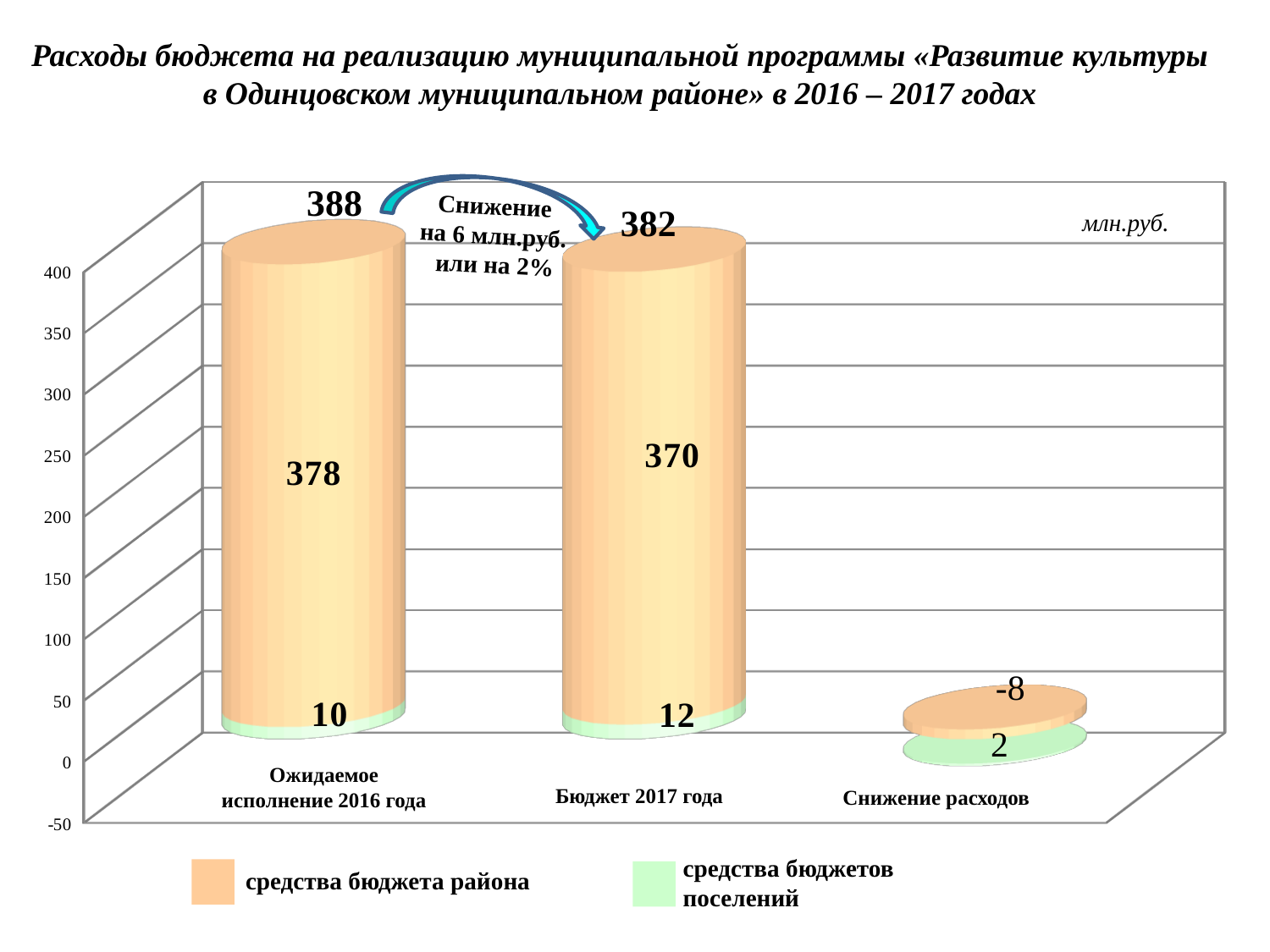
Which is larger: «средства бюджетов поселений» for «Ожидаемое исполнение 2016 года» or for «Бюджет 2017 года»? Бюджет 2017 года How many categories are shown on the x axis? 3 How many series does the legend list? 2 What is the total of the stacked bar for «Ожидаемое исполнение 2016 года»? 388 What is the total of the stacked bar for «Бюджет 2017 года»? 382 What is the difference between the «средства бюджета района» values for «Ожидаемое исполнение 2016 года» and «Бюджет 2017 года»? 8 What kind of chart is shown on the slide? Stacked bar chart Which category has the highest total value? Ожидаемое исполнение 2016 года What is the value of «средства бюджета района» for «Ожидаемое исполнение 2016 года»? 378 What is the value of «средства бюджетов поселений» for «Бюджет 2017 года»? 12 What is the value of «средства бюджета района» for «Снижение расходов»? -8 What is the value of «средства бюджетов поселений» for «Ожидаемое исполнение 2016 года»? 10